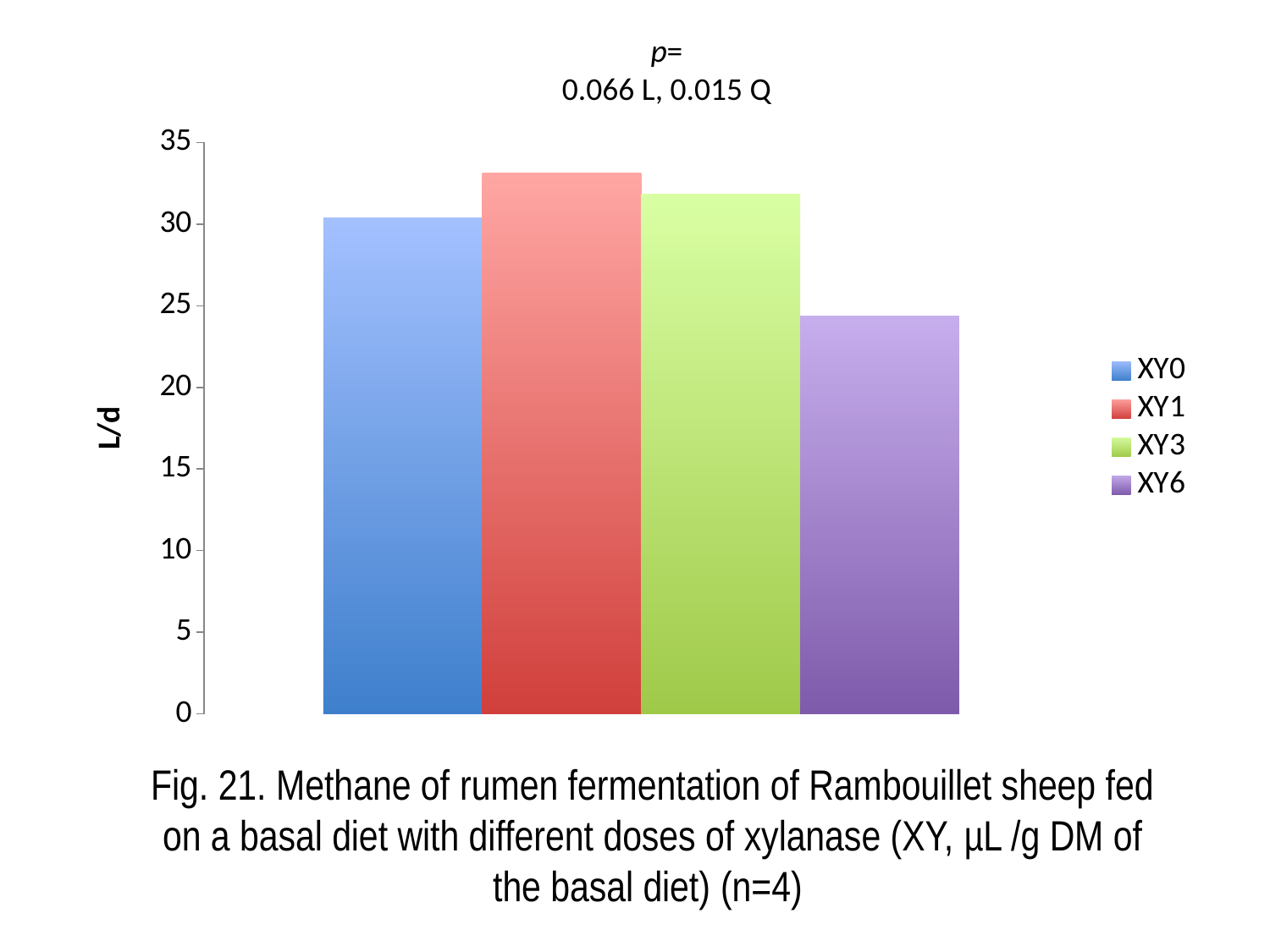
What is the label on the vertical axis of the chart? L/d Is the value for XY1 greater or less than 35? less Which series has the highest value? XY1 Which is larger, the value for XY1 or the value for XY0? XY1 How many series does the legend list? 4 What kind of chart is shown on the slide? bar chart Which series has the lowest value? XY6 How many bars are plotted in the chart? 4 Is the value for XY6 greater or less than 25? less Is the value for XY3 greater or less than 30? greater Which is larger, the value for XY0 or the value for XY6? XY0